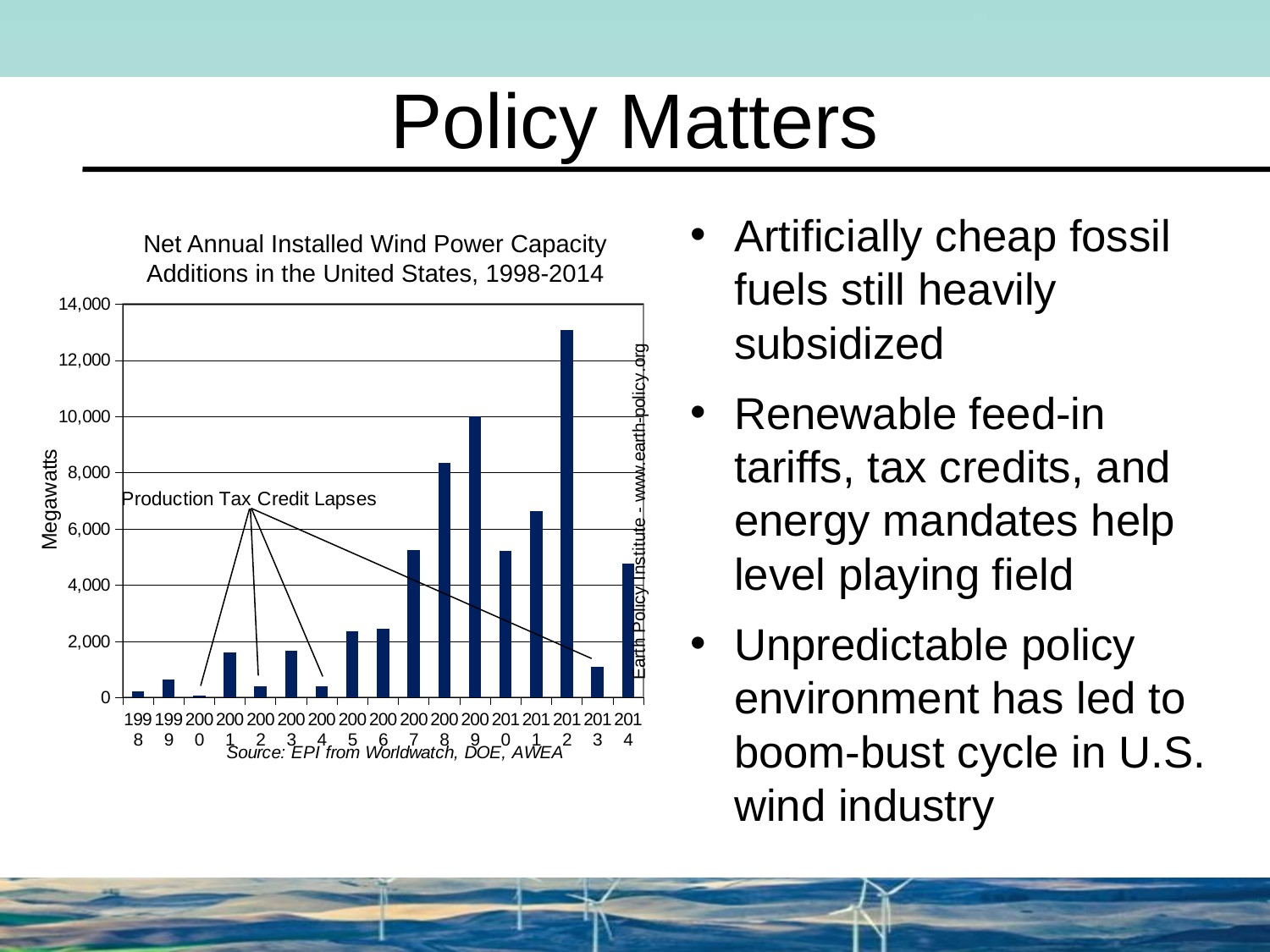
Is the value for 2007 greater or less than 4,000 megawatts? greater What unit is shown on the y-axis of the chart? Megawatts Is the value for 2008 greater or less than 8,000 megawatts? greater Which year has the lowest net annual installed wind power capacity addition? 2000 What is the title of the chart? Net Annual Installed Wind Power Capacity Additions in the United States, 1998-2014 Is the value for 2013 greater or less than 2,000 megawatts? less Which year has the highest net annual installed wind power capacity addition? 2012 What kind of chart is shown on the slide? bar chart Which year has the larger value, 2009 or 2011? 2009 Which year has the larger value, 2013 or 2014? 2014 How many years (bars) are plotted in the chart? 17